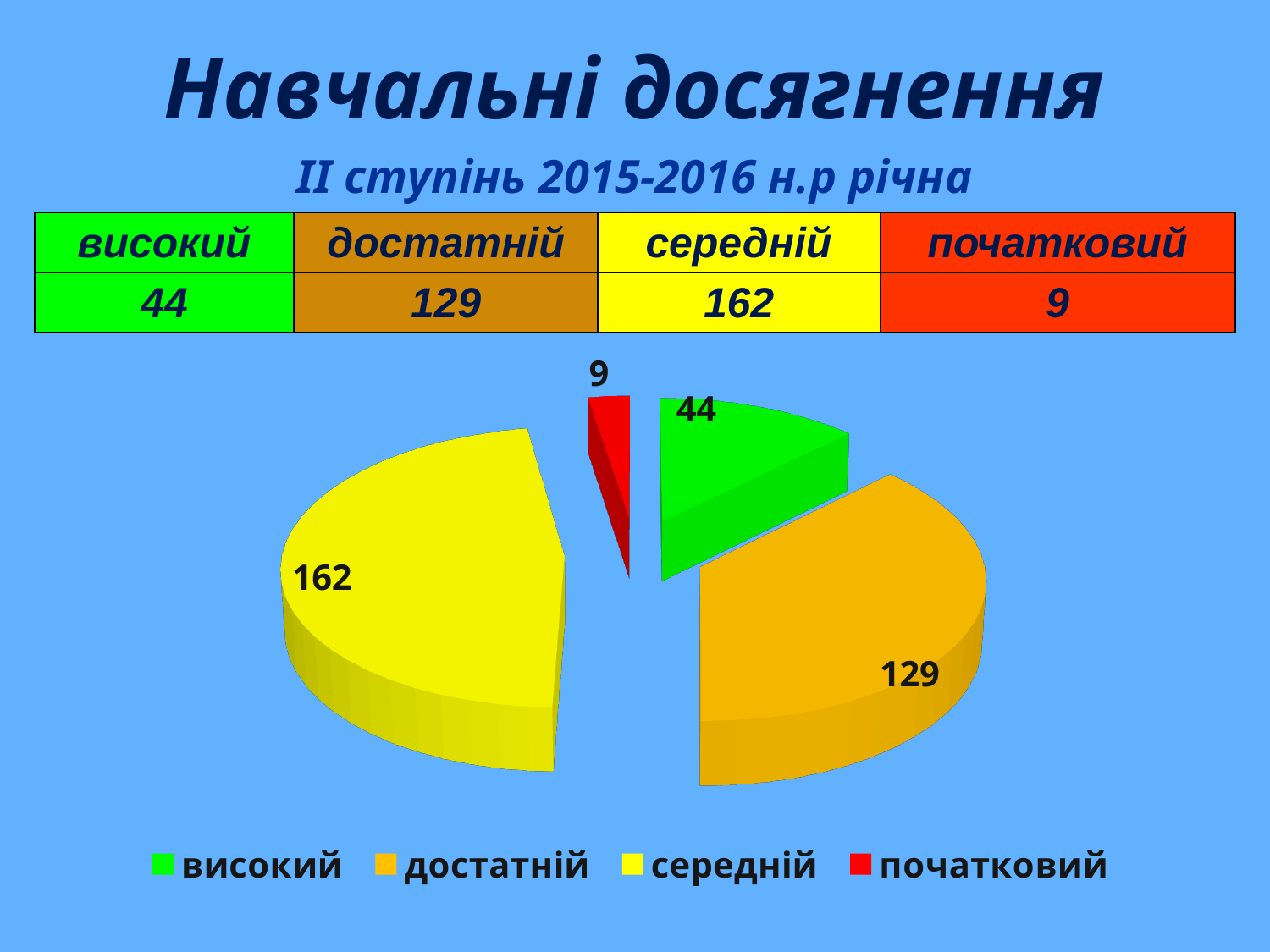
What is the value for the "достатній" slice of the pie chart? 129 What is the value for the "початковий" slice of the pie chart? 9 What colour is the "початковий" slice in the pie chart? red What is the value for the "середній" slice of the pie chart? 162 Which is larger, the value for "високий" or the value for "початковий"? високий What is the value for the "високий" slice of the pie chart? 44 What is the difference between the values for "середній" and "достатній"? 33 Which category has the smallest slice in the pie chart? початковий How many slices does the pie chart have? 4 What kind of chart is shown on the slide? pie chart Which category has the largest slice in the pie chart? середній What is the total of all the values shown in the pie chart? 344